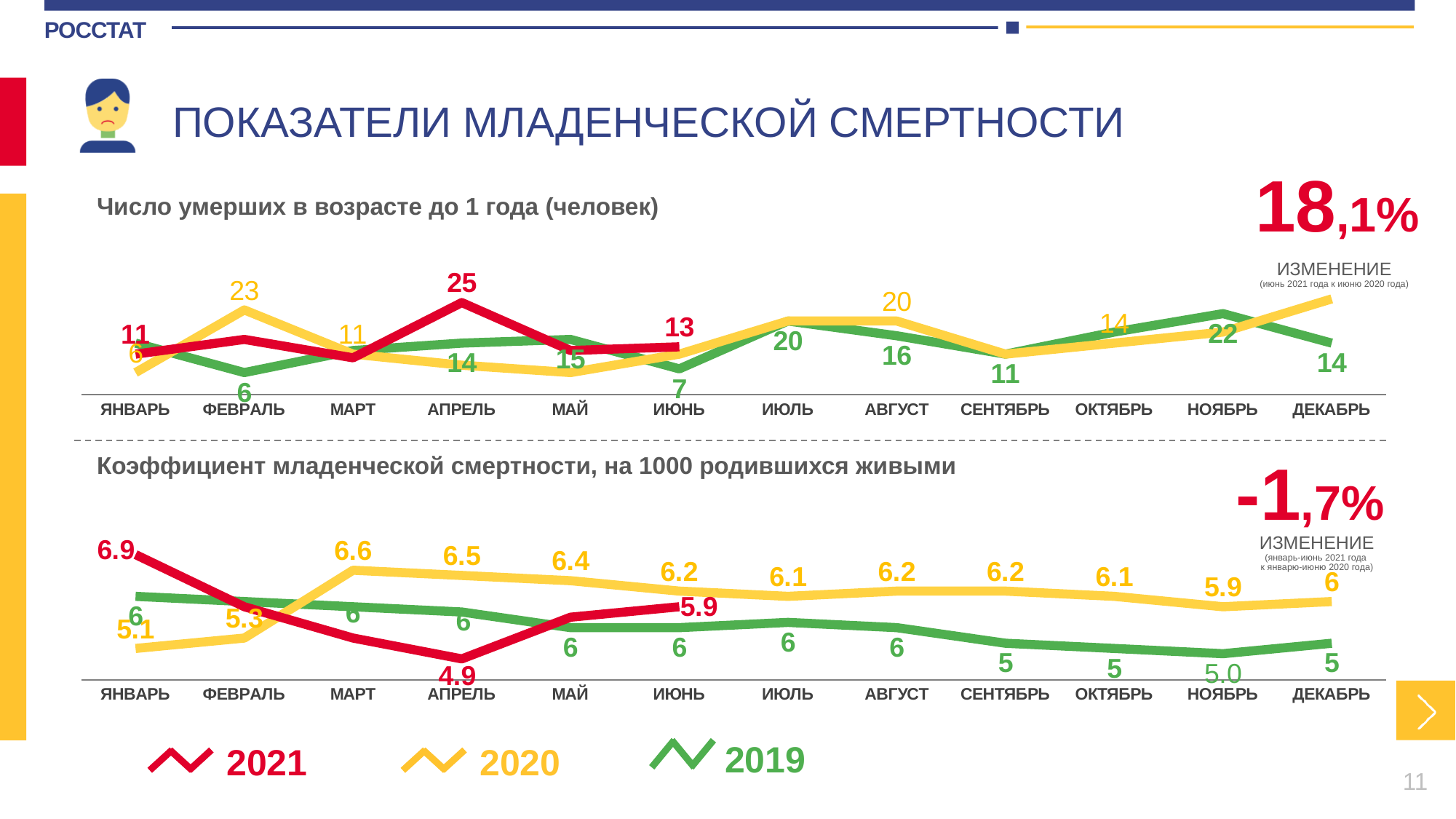
In the bottom chart (Коэффициент младенческой смертности), does the 2021 line rise or fall from ЯНВАРЬ to АПРЕЛЬ? Fall In the top chart (Число умерших в возрасте до 1 года), which month has the highest 2021 value? АПРЕЛЬ In the bottom chart (Коэффициент младенческой смертности), which is larger for ИЮНЬ: the 2021 value or the 2020 value? 2020 How many series does the legend list? 3 In the top chart (Число умерших в возрасте до 1 года), what is the 2020 value for ФЕВРАЛЬ? 23 What kind of chart is the top chart (Число умерших в возрасте до 1 года)? Line chart In the bottom chart (Коэффициент младенческой смертности), which month has the lowest 2021 value? АПРЕЛЬ In the top chart (Число умерших в возрасте до 1 года), what is the 2019 value for НОЯБРЬ? 22 In the bottom chart (Коэффициент младенческой смертности), what is the 2021 value for ЯНВАРЬ? 6.9 In the top chart (Число умерших в возрасте до 1 года), what is the difference between the 2021 values for АПРЕЛЬ and ИЮНЬ? 12 In the bottom chart (Коэффициент младенческой смертности), what is the 2020 value for МАРТ? 6.6 In the top chart (Число умерших в возрасте до 1 года), what is the 2021 value for АПРЕЛЬ? 25